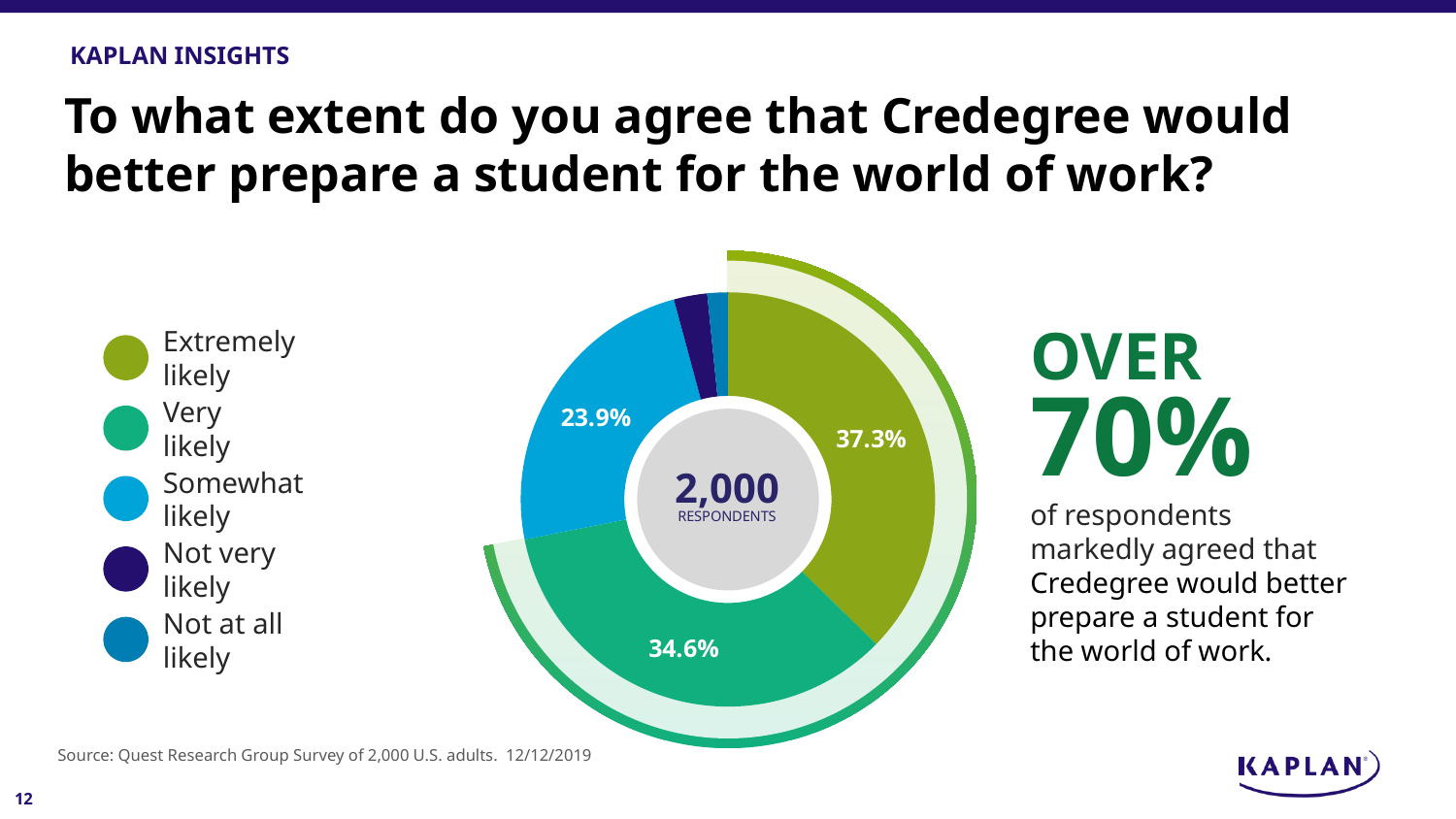
How many respondents does the centre of the chart say took part in the survey? 2,000 What is the combined percentage of the three labelled slices (Extremely likely, Very likely, Somewhat likely)? 95.8% What percentage of respondents said "Extremely likely"? 37.3% How many response categories does the legend list? 5 What is the difference in percentage points between "Very likely" and "Somewhat likely"? 10.7 What percentage of respondents said "Somewhat likely"? 23.9% What kind of chart is shown on the slide? Pie (donut) chart Which is larger, the share for "Extremely likely" or the share for "Somewhat likely"? Extremely likely What percentage of respondents said "Very likely"? 34.6% What is the difference in percentage points between "Extremely likely" and "Very likely"? 2.7 Which legend entry is shown in dark navy? Not very likely Which response category has the largest share of the chart? Extremely likely